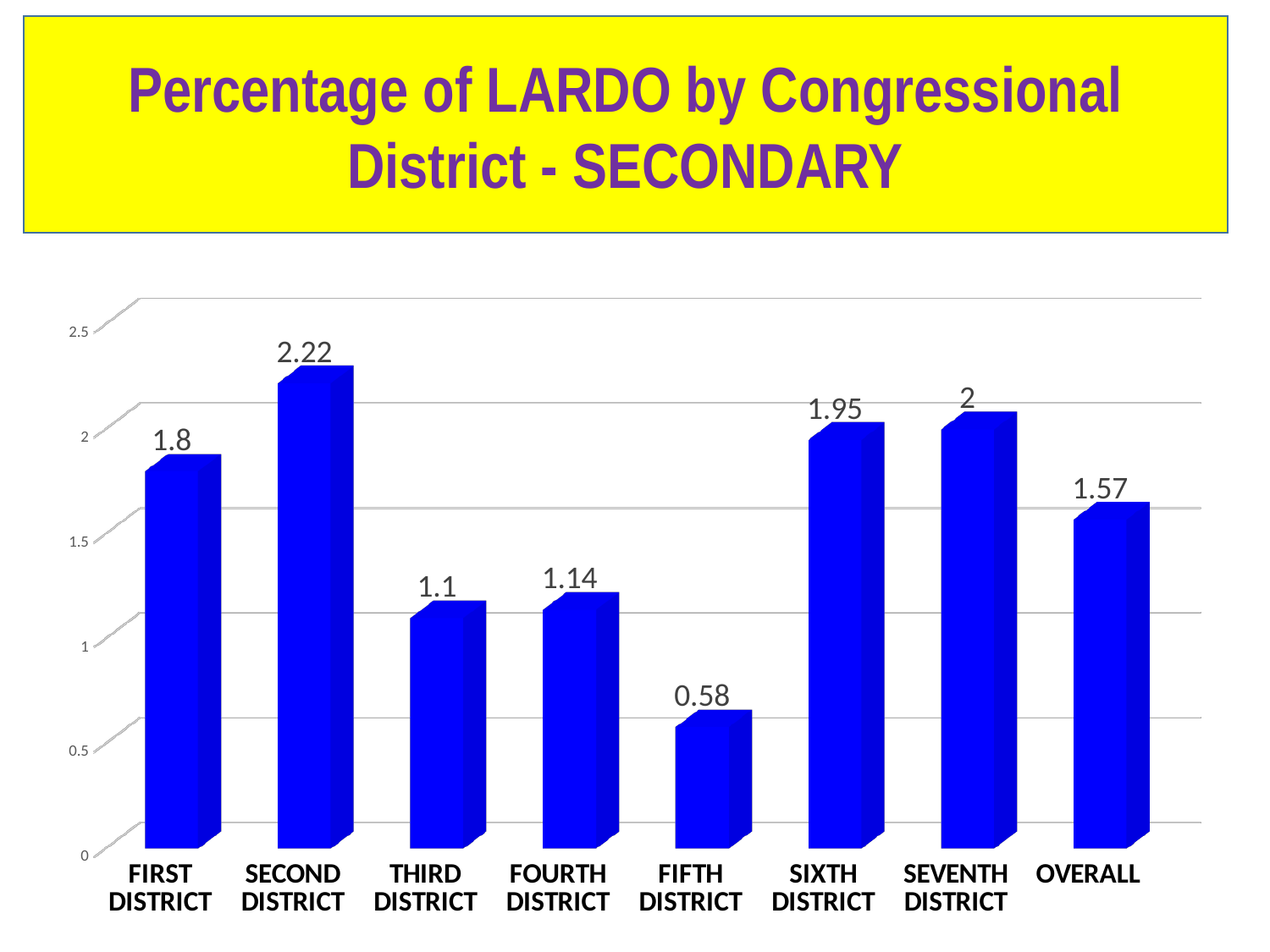
What is the value for the Seventh District? 2 What is the Overall value shown on the chart? 1.57 Which is larger, the value for the First District or the Sixth District? Sixth District What kind of chart is shown on the slide? Bar chart What is the value for the Second District? 2.22 Is the value for the Fourth District greater or less than 1.5? less Which district has the lowest value? Fifth District What is the value for the Fifth District? 0.58 What is the difference between the Second District and the Fifth District values? 1.64 Which district has the highest value? Second District What is the title of the chart on the slide? Percentage of LARDO by Congressional District - SECONDARY How many bars are shown on the chart? 8